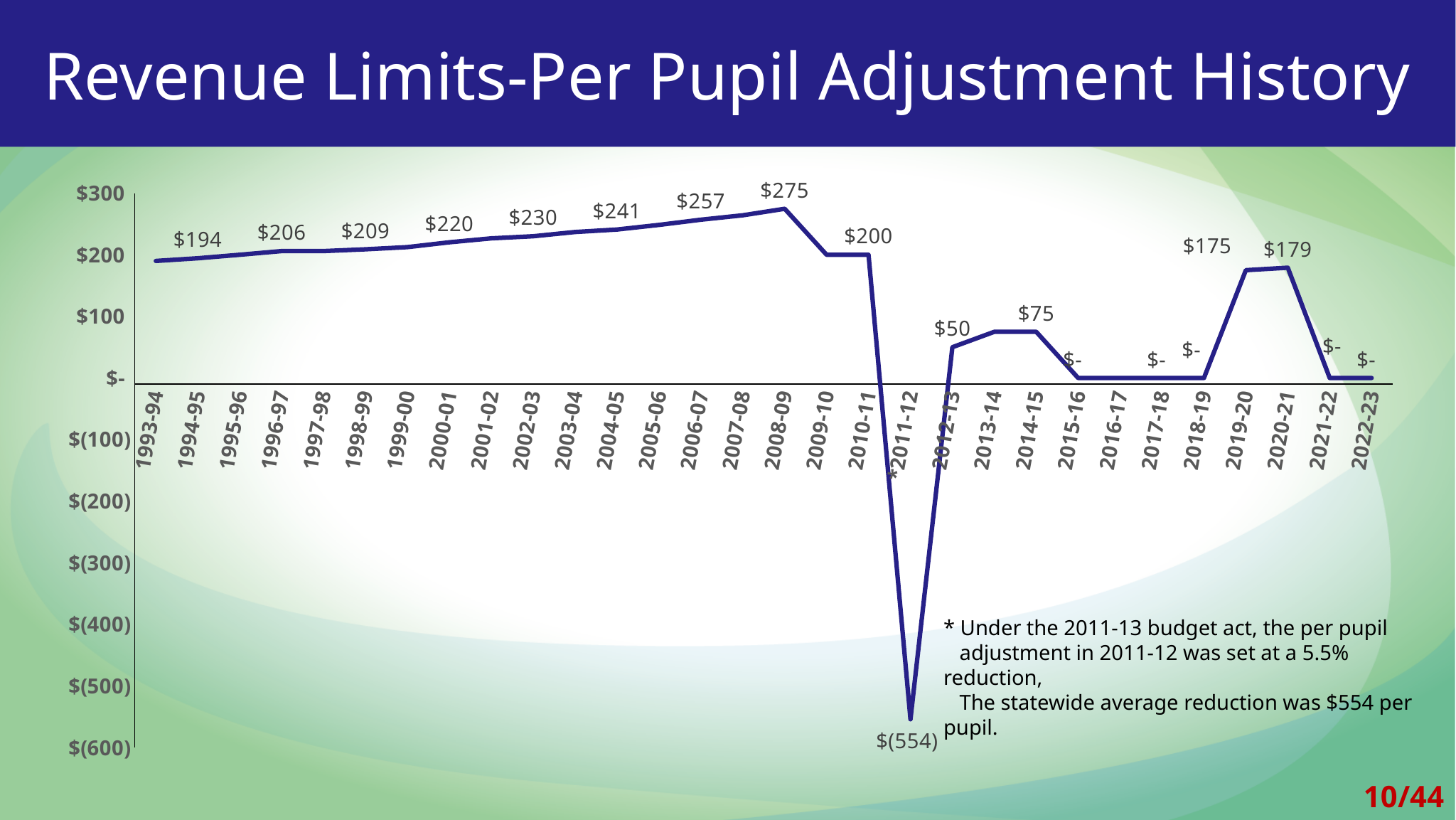
Which is larger, the per pupil adjustment in 2008-09 or in 2010-11? 2008-09 According to the footnote, what was the statewide average reduction per pupil in 2011-12? $554 What kind of chart is shown on the slide? line chart What is the per pupil adjustment value for 2020-21? $179 Does the per pupil adjustment generally rise or fall from 1993-94 to 2008-09? rise What is the difference between the per pupil adjustment in 2020-21 and in 2019-20? $4 What is the per pupil adjustment value for 2019-20? $175 Which year has the lowest per pupil adjustment? 2011-12 What is the per pupil adjustment value for 2011-12? $(554) Which year has the highest per pupil adjustment? 2008-09 What is the highest per pupil adjustment value shown on the chart? $275 How many school years are plotted on the x axis? 30